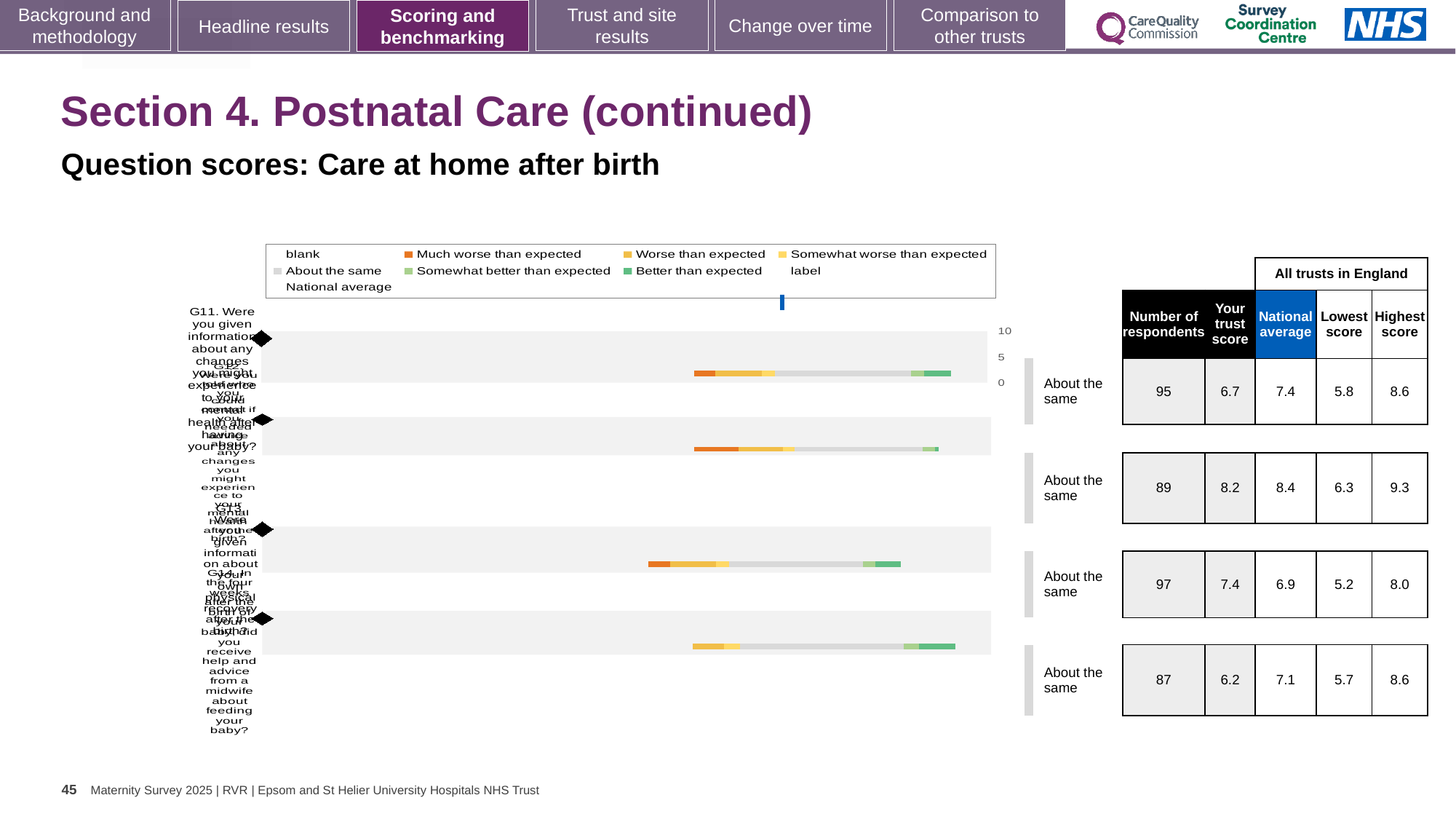
What is the number of respondents for the fourth row of the table? 87 Which row of the table has the highest 'Highest score' value, and what is it? second row, 9.3 What is the heading above the National average, Lowest score and Highest score columns in the table? All trusts in England In the third row of the table, which is larger: the trust score or the national average? trust score In the chart legend, what colour represents 'Much worse than expected'? orange What kind of chart is shown on the slide? bar chart How many question rows (bars) are plotted in the chart? 4 What is the lowest 'Lowest score' value shown in the table? 5.2 What is the number of respondents for the first row of the table? 95 What is the national average for the second row of the table? 8.4 In the first row of the table, what is the difference between the national average and the trust score? 0.7 What is the trust score for the first row of the table? 6.7